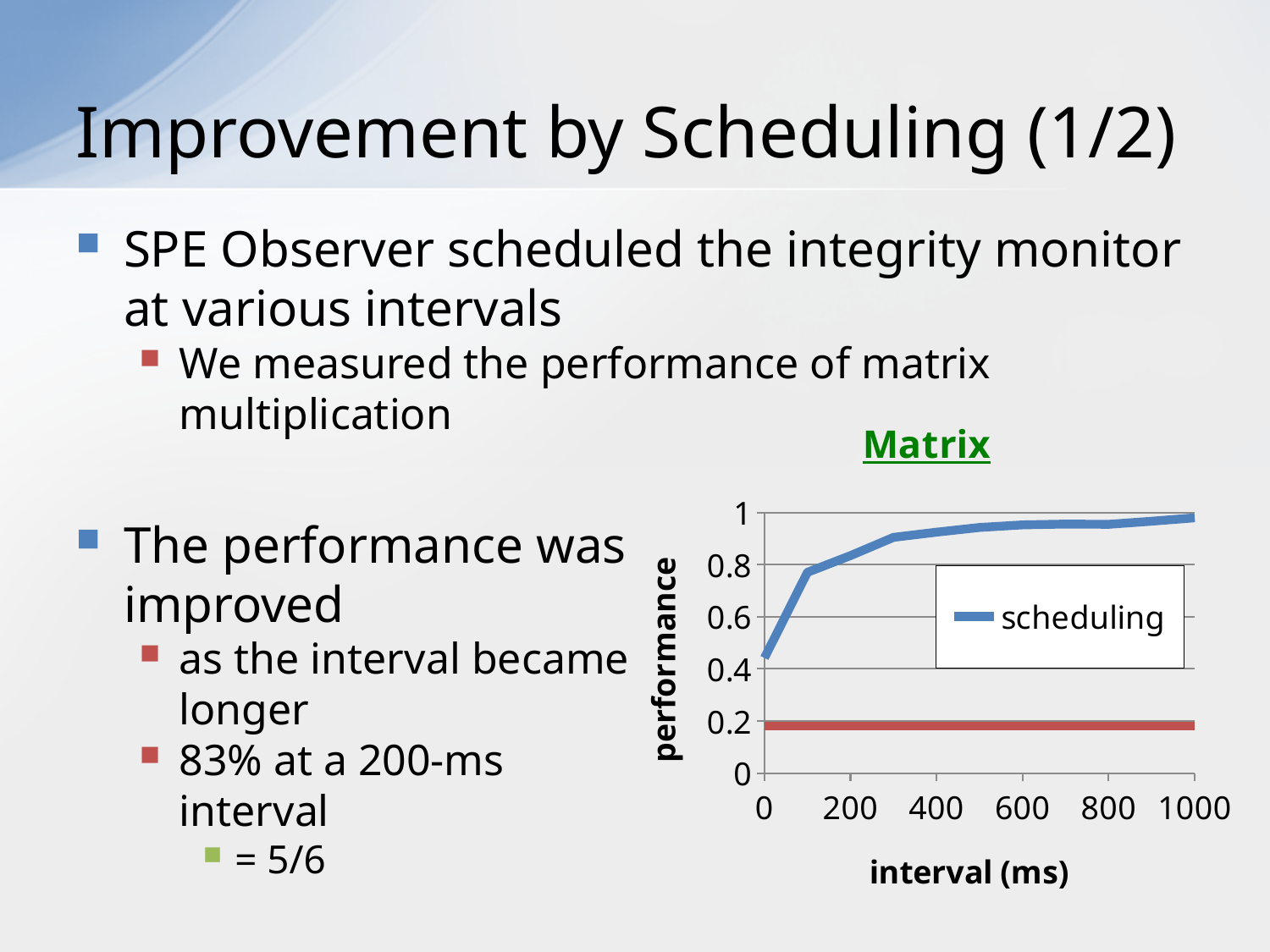
Does the scheduling line rise or fall as the interval increases from 0 to 1000 ms? rise Is the scheduling value at an interval of 1000 ms greater or less than 0.8? greater Is the scheduling value at an interval of 200 ms greater or less than 0.6? greater What is the highest tick value shown on the y axis of the chart? 1 Is the value of the flat red line greater or less than 0.4? less What is the label of the x axis of the chart? interval (ms) At an interval of 1000 ms, which line is higher: the blue scheduling line or the red line? the blue scheduling line What kind of chart is shown on the slide? line chart How many series does the chart's legend list? 1 What is the title of the chart? Matrix